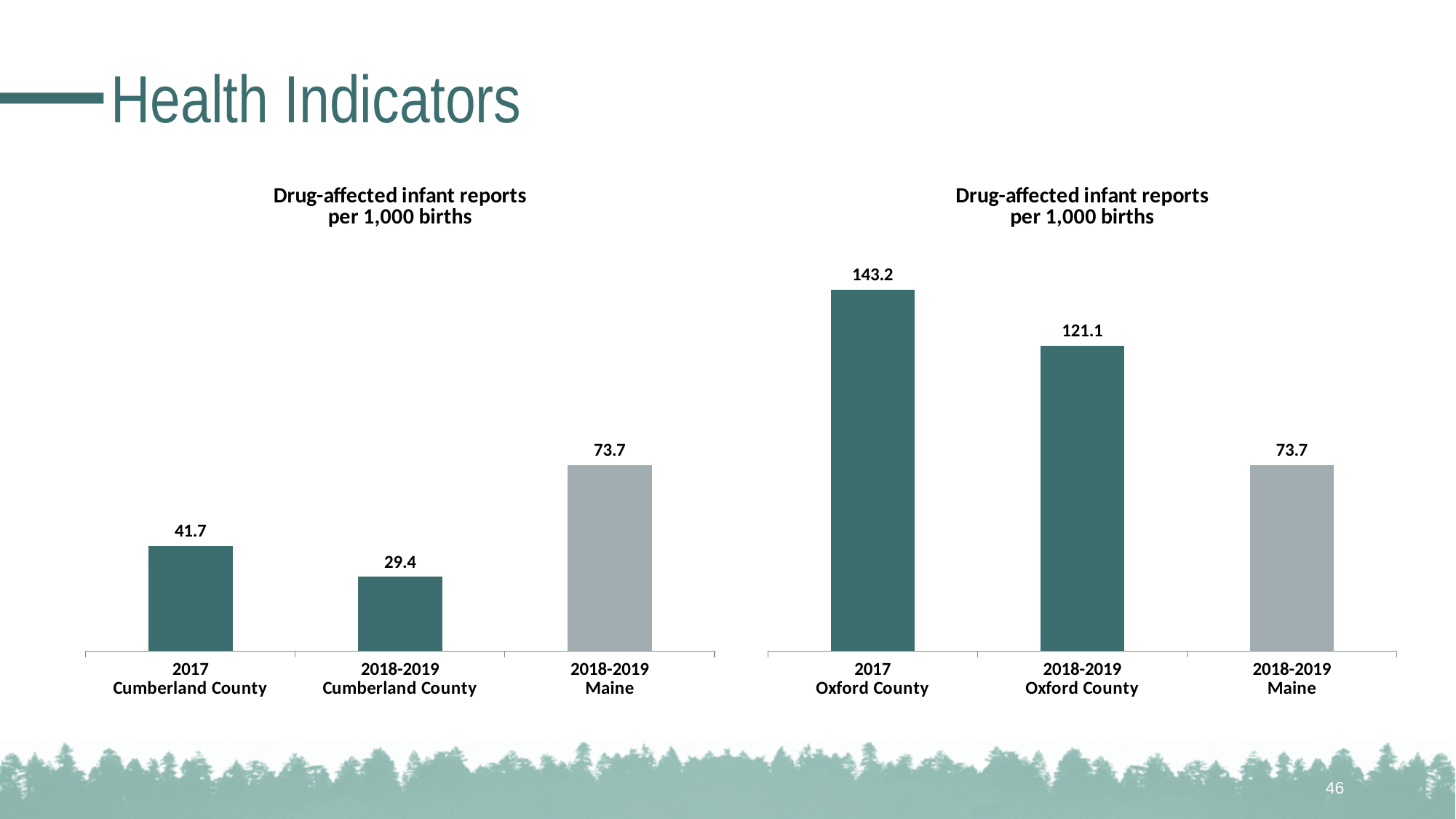
What is the title of the left chart? Drug-affected infant reports per 1,000 births In the right chart (Oxford County), what is the difference between the 2017 Oxford County value and the 2018-2019 Oxford County value? 22.1 In the right chart (Oxford County), what is the value for 2018-2019 Maine? 73.7 In the left chart (Cumberland County), which category has the highest value? 2018-2019 Maine How many bars are in the left chart (Cumberland County)? 3 In the left chart (Cumberland County), what is the difference between the 2018-2019 Maine value and the 2018-2019 Cumberland County value? 44.3 In the right chart (Oxford County), which is larger: the value for 2018-2019 Oxford County or the value for 2018-2019 Maine? 2018-2019 Oxford County In the right chart (Oxford County), which category has the lowest value? 2018-2019 Maine In the left chart (Cumberland County), what is the value for 2018-2019 Cumberland County? 29.4 In the right chart (Oxford County), what is the value for 2017 Oxford County? 143.2 What kind of chart is the right chart (Oxford County)? Bar chart In the left chart (Cumberland County), what is the value for 2017 Cumberland County? 41.7